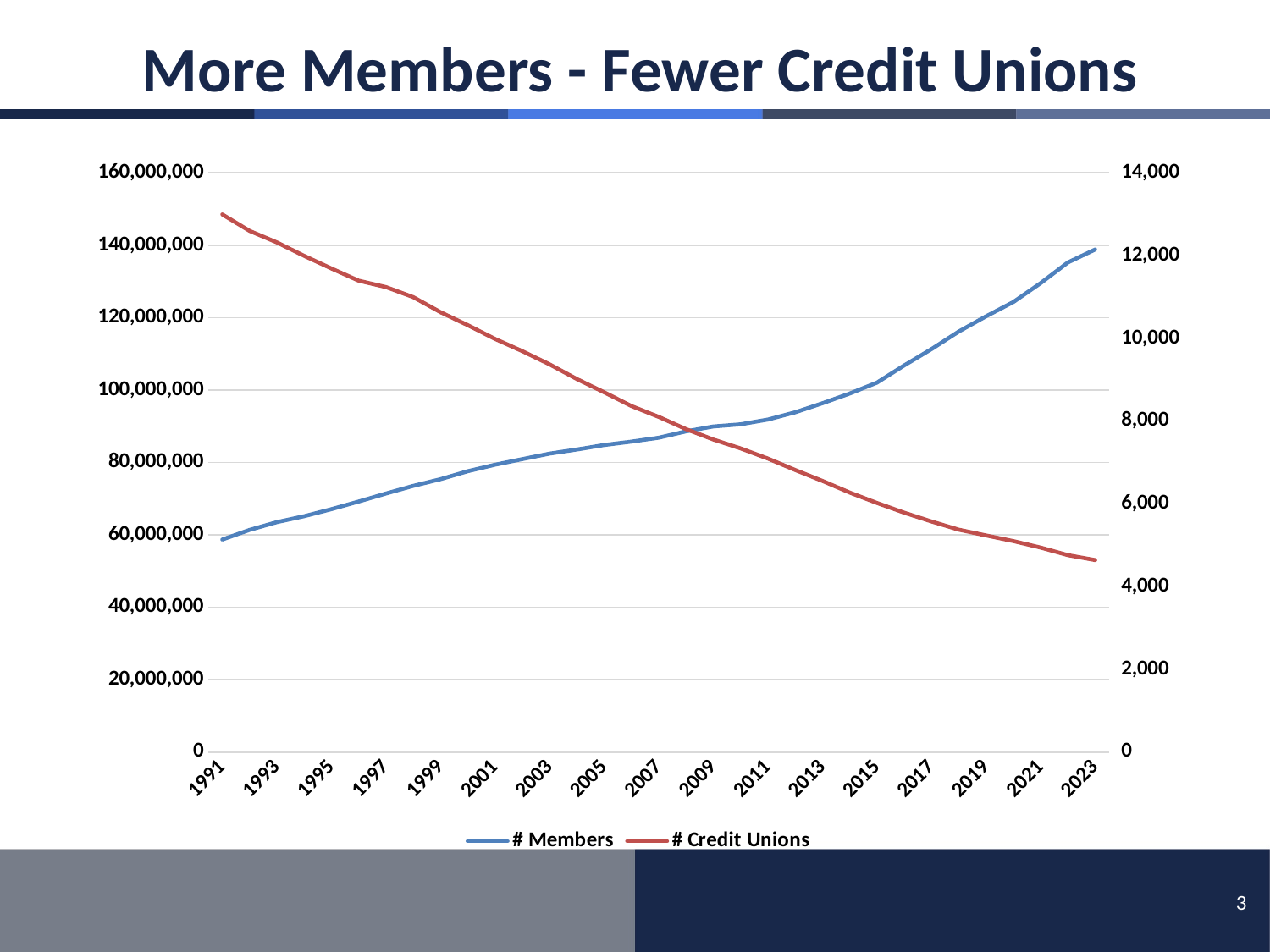
In which year is # Members highest? 2023 Is the value for # Credit Unions in 2023 greater or less than 6,000? less What colour is the # Credit Unions line? red Is the value for # Credit Unions in 1991 greater or less than 12,000? greater What is the title of the chart on the slide? More Members - Fewer Credit Unions How many series does the legend list? 2 Is the value for # Members in 2023 greater or less than 120,000,000? greater In which year is # Credit Unions lowest? 2023 Does the # Credit Unions series rise or fall from 1991 to 2023? fall In which year is # Credit Unions highest? 1991 Does the # Members series rise or fall from 1991 to 2023? rise What kind of chart is shown on the slide? line chart